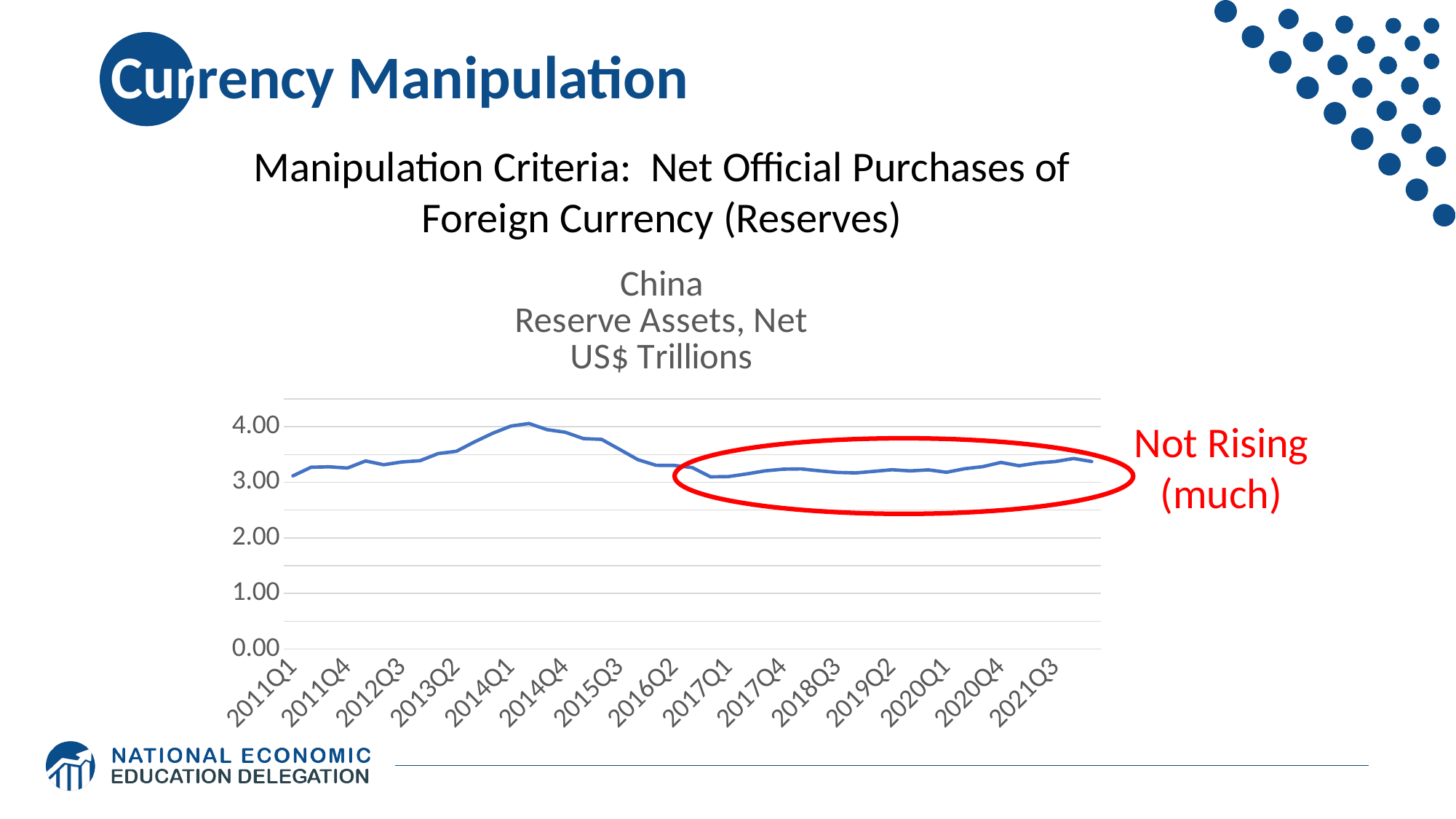
What kind of chart is shown on the slide? Line chart Which is larger, the value for 2014Q1 or the value for 2017Q1? 2014Q1 Does the line rise or fall between 2014Q4 and 2016Q2? Falls What is the title of the chart? China Reserve Assets, Net US$ Trillions Is the value for 2013Q2 greater or less than 3.00? greater Does the line rise or fall between 2011Q1 and 2014Q1? Rises In what units are the values on the chart expressed? US$ Trillions Is the value for 2011Q4 greater or less than 3.00? greater Is the value for 2016Q2 greater or less than 4.00? less Which is larger, the value for 2011Q1 or the value for 2013Q2? 2013Q2